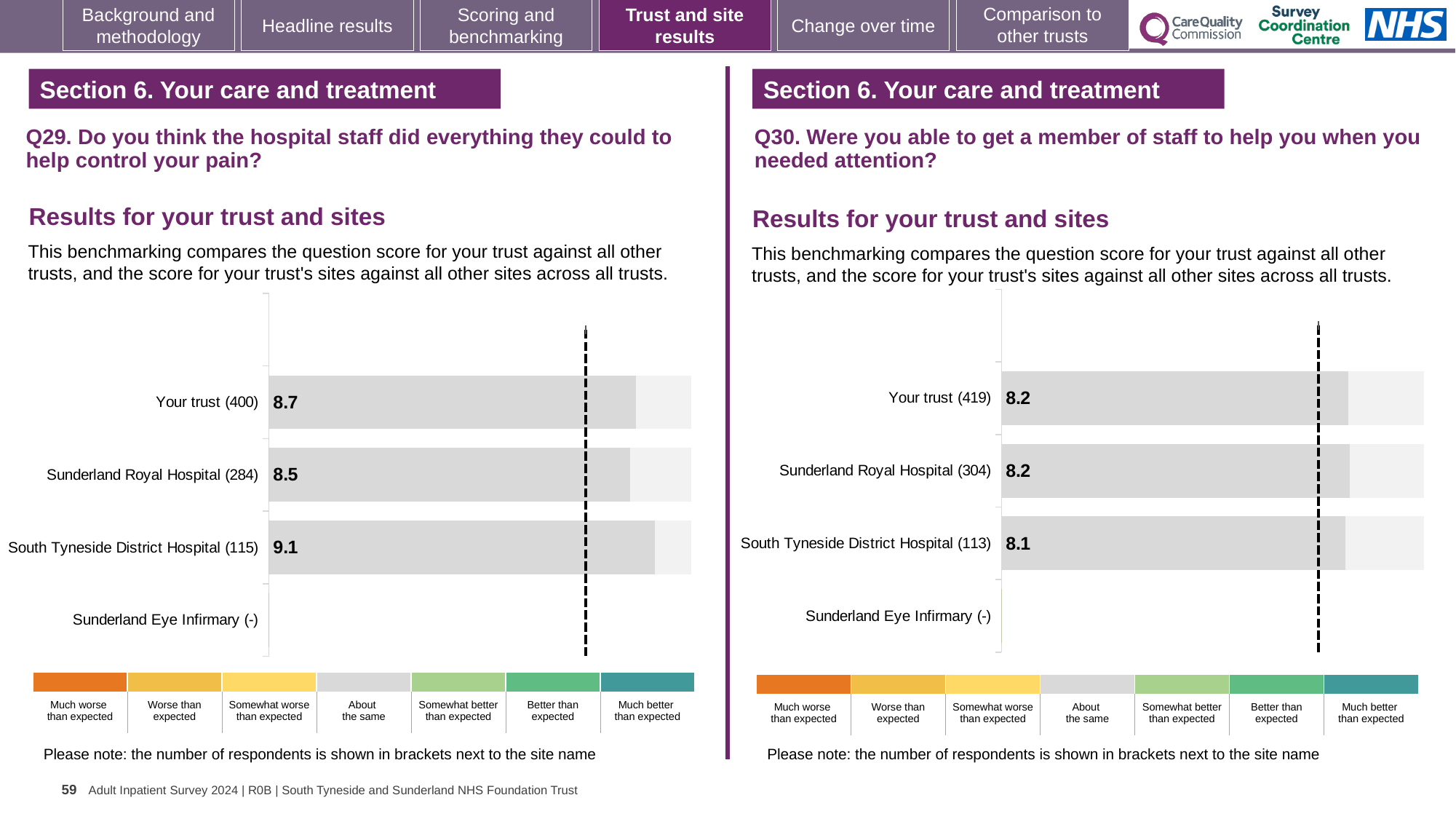
In the Q30 chart on the right, what is the score for Your trust? 8.2 In the Q30 chart on the right, what is the difference between the scores for Your trust and South Tyneside District Hospital? 0.1 In the Q30 chart on the right, which site has the lowest score among those with a value shown? South Tyneside District Hospital How many respondents are shown in brackets for Your trust in the Q30 chart on the right? 419 In the Q29 chart on the left, what is the score for Your trust? 8.7 Which is larger: the Your trust score in the Q29 chart or the Your trust score in the Q30 chart? Q29 (8.7) What kind of chart is used in the Q29 chart on the left? Bar chart In the Q29 chart on the left, what is the score for Sunderland Royal Hospital? 8.5 In the Q29 chart on the left, what is the difference between the scores for South Tyneside District Hospital and Sunderland Royal Hospital? 0.6 In the Q29 chart on the left, which site has the highest score? South Tyneside District Hospital In the Q29 chart on the left, what is the score for South Tyneside District Hospital? 9.1 In the Q30 chart on the right, what is the score for South Tyneside District Hospital? 8.1